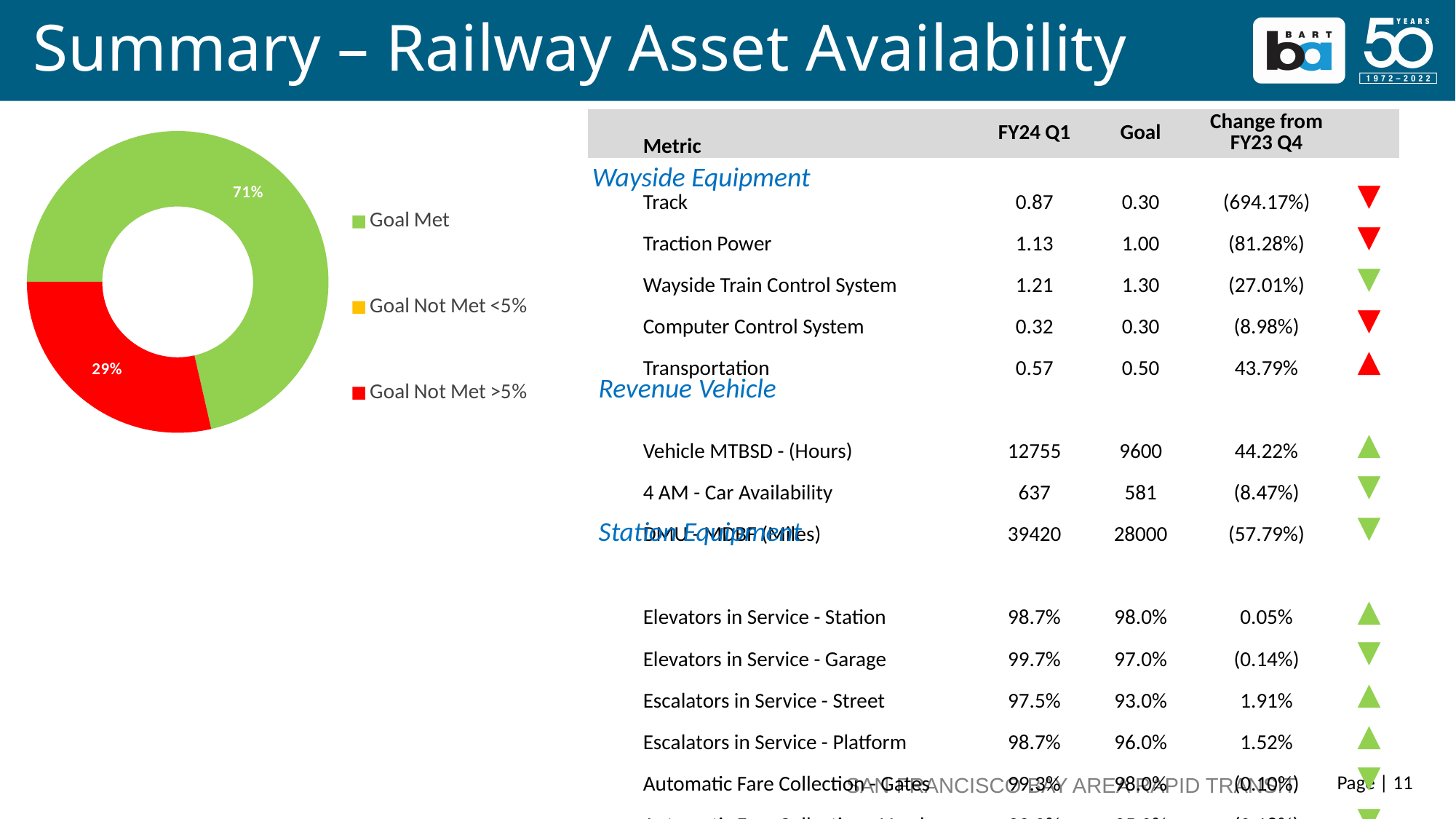
What colour represents Goal Met in the doughnut chart? green Is the Goal Met share in the doughnut chart greater or less than 50%? greater In the doughnut chart, what percentage is shown for Goal Met? 71% Which category has the largest slice in the doughnut chart? Goal Met In the doughnut chart, what percentage is shown for Goal Not Met >5%? 29% What colour represents Goal Not Met >5% in the doughnut chart? red What do the two labelled slices of the doughnut chart add up to? 100% Which is larger in the doughnut chart, Goal Met or Goal Not Met >5%? Goal Met What is the difference in percentage points between the Goal Met slice and the Goal Not Met >5% slice? 42% How many slices with data labels are visible in the doughnut chart? 2 What kind of chart is shown on the left of the slide? doughnut chart How many entries does the legend of the doughnut chart list? 3